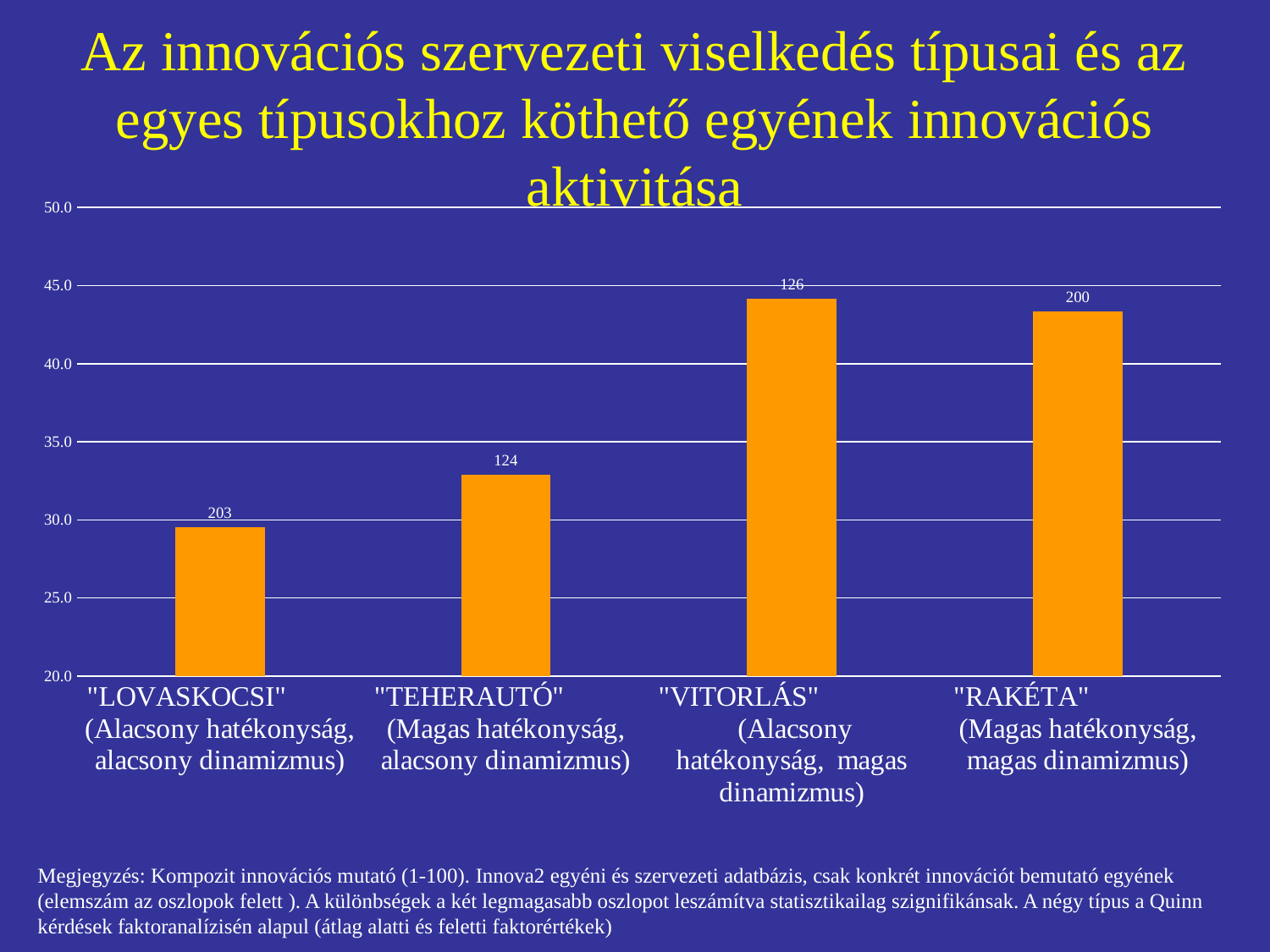
Which category has the lowest bar? "LOVASKOCSI" Is the value for "LOVASKOCSI" greater or less than 30.0? less What number (element count) is printed above the bar for "RAKÉTA"? 200 Is the value for "VITORLÁS" greater or less than 40.0? greater Which category has the highest bar? "VITORLÁS" What number (element count) is printed above the bar for "LOVASKOCSI"? 203 Is the value for "TEHERAUTÓ" greater or less than 35.0? less How many categories (bars) does the chart show? 4 What kind of chart is shown on the slide? bar chart Which bar is taller, "TEHERAUTÓ" or "RAKÉTA"? "RAKÉTA"